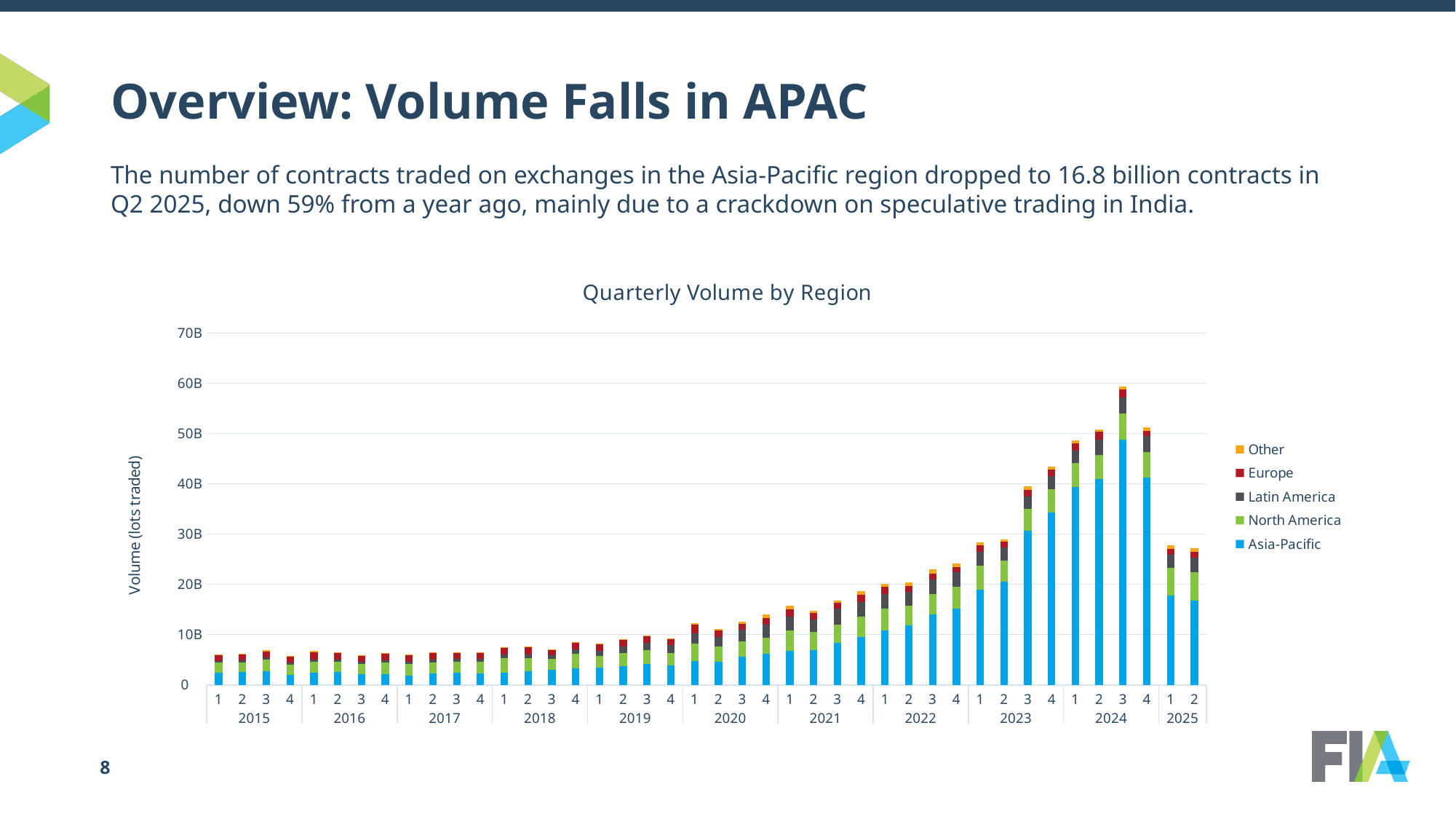
Is the total volume for Q1 2015 greater or less than 10B? less Does total quarterly volume rise or fall from Q3 2024 to Q2 2025? Fall Which quarter has the tallest stacked bar in the Quarterly Volume by Region chart? Q3 2024 Is the Asia-Pacific volume in Q3 2024 greater or less than 40B? greater How many series does the legend of the Quarterly Volume by Region chart list? 5 Is the total volume for Q3 2024 greater or less than 50B? greater What is the label on the vertical axis of the chart? Volume (lots traded) What kind of chart is shown on the slide? Stacked bar chart Which has the larger total volume, Q4 2024 or Q1 2025? Q4 2024 Which region accounts for the largest portion of the Q3 2024 bar? Asia-Pacific How many quarterly bars are plotted in the Quarterly Volume by Region chart? 42